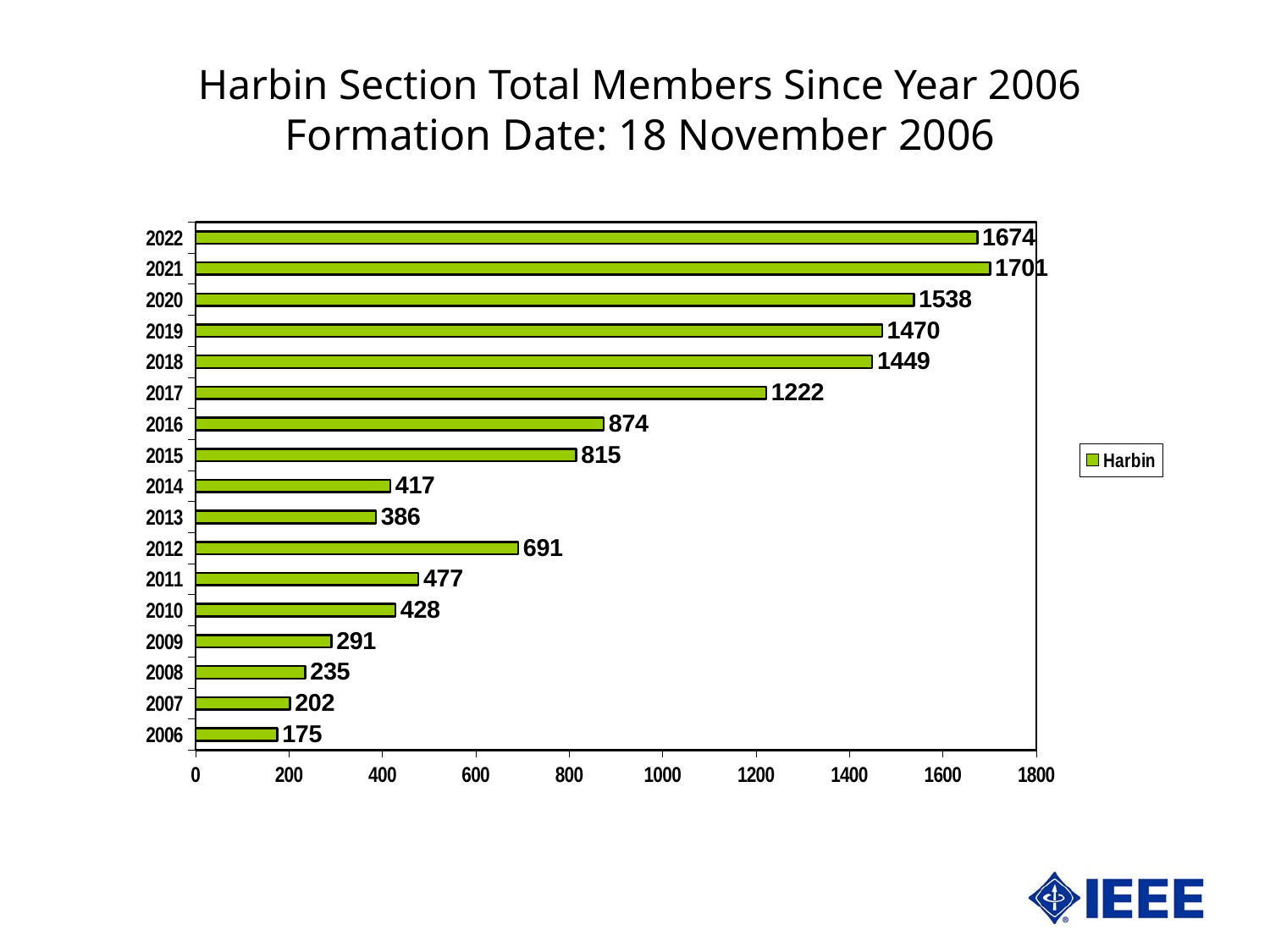
Which is larger, the value for 2012 or the value for 2013? 2012 Which year has the lowest value? 2006 What is the value for 2017? 1222 What is the difference between the values for 2021 and 2022? 27 What kind of chart is shown? bar chart How many years are shown in the chart? 17 How many series does the legend list? 1 What is the value for 2012? 691 What is the value for 2006? 175 What is the name of the series in the legend? Harbin Which year has the highest value? 2021 What is the difference between the values for 2016 and 2015? 59